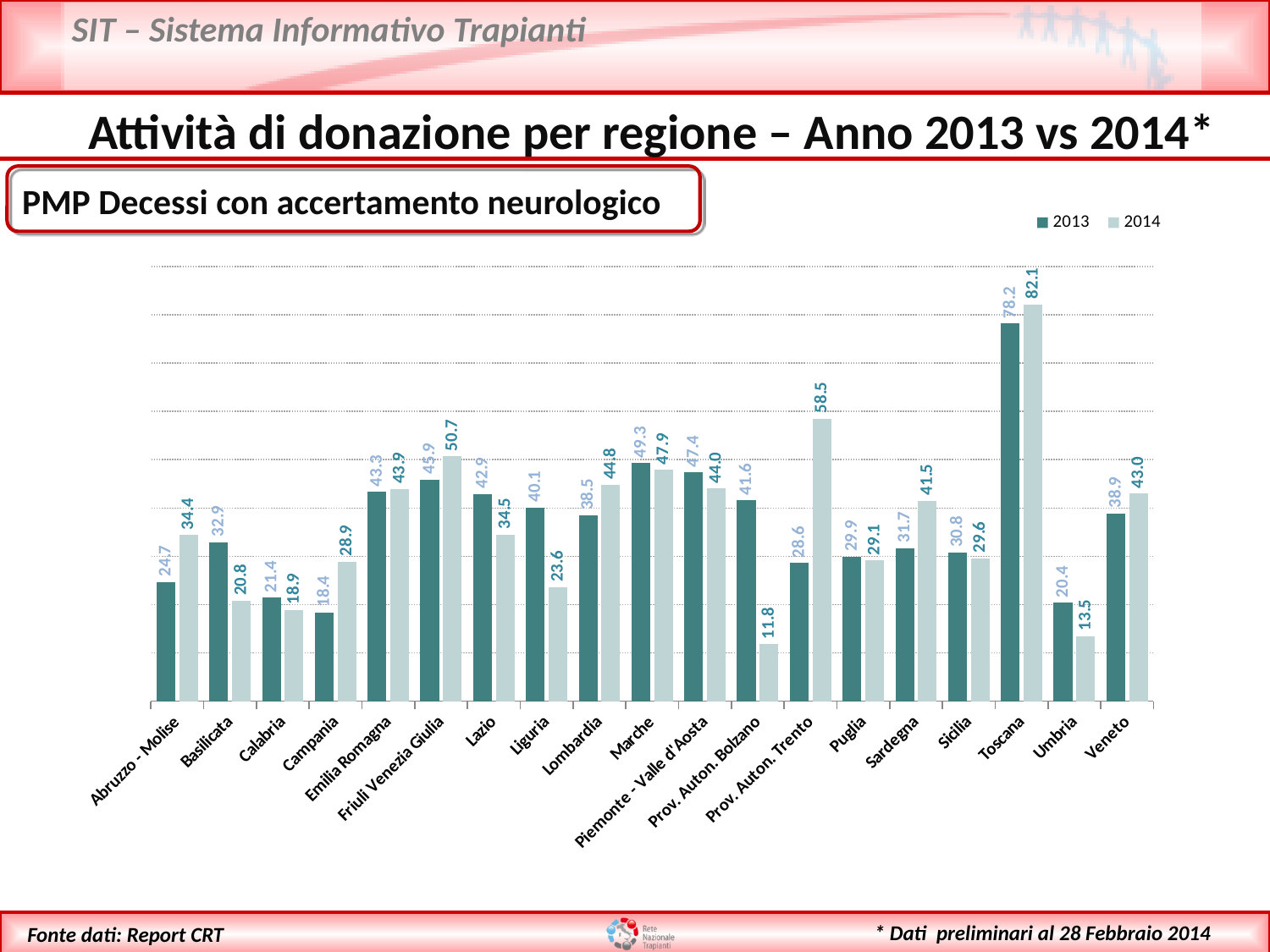
What kind of chart is shown on the slide? Bar chart What is the 2013 value for Prov. Auton. Bolzano? 41.6 What is the difference between the 2014 and 2013 values for Prov. Auton. Trento? 29.9 What are the two series named in the legend? 2013 and 2014 Which region has the highest 2013 value? Toscana What is the 2014 value for Prov. Auton. Trento? 58.5 How many series does the legend list? 2 Which is larger for Lazio, the 2013 value or the 2014 value? 2013 What is the difference between the 2013 and 2014 values for Umbria? 6.9 How many regions are shown on the x axis? 19 What is the 2014 value for Toscana? 82.1 Which region has the lowest 2014 value? Prov. Auton. Bolzano